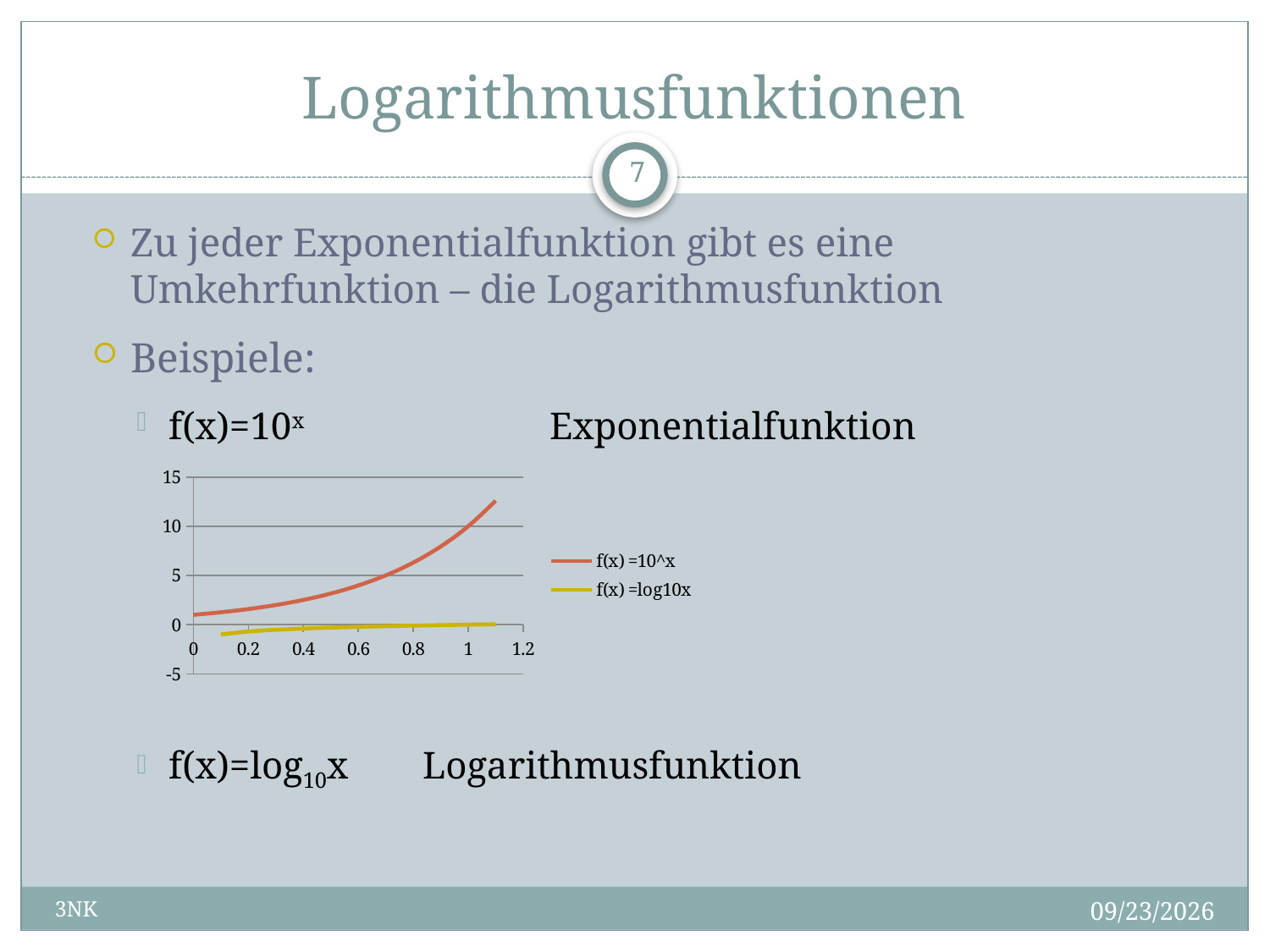
What are the two series named in the chart's legend? f(x) =10^x and f(x) =log10x At x = 1, which series has the higher value, f(x) =10^x or f(x) =log10x? f(x) =10^x Is the value of f(x) =10^x at x = 1.1 greater or less than 10? greater Is the value of f(x) =10^x at x = 0.6 greater or less than 5? less What is the highest value shown on the chart's y axis? 15 How many series does the chart's legend list? 2 How many tick labels are shown on the chart's x axis? 7 Which colour is used for the f(x) =10^x series in the chart? red Does the f(x) =log10x series rise or fall as x increases? rise What kind of chart is shown on the slide? line chart Does the f(x) =10^x series rise or fall as x increases? rise Is the value of f(x) =log10x at x = 0.4 greater or less than 5? less